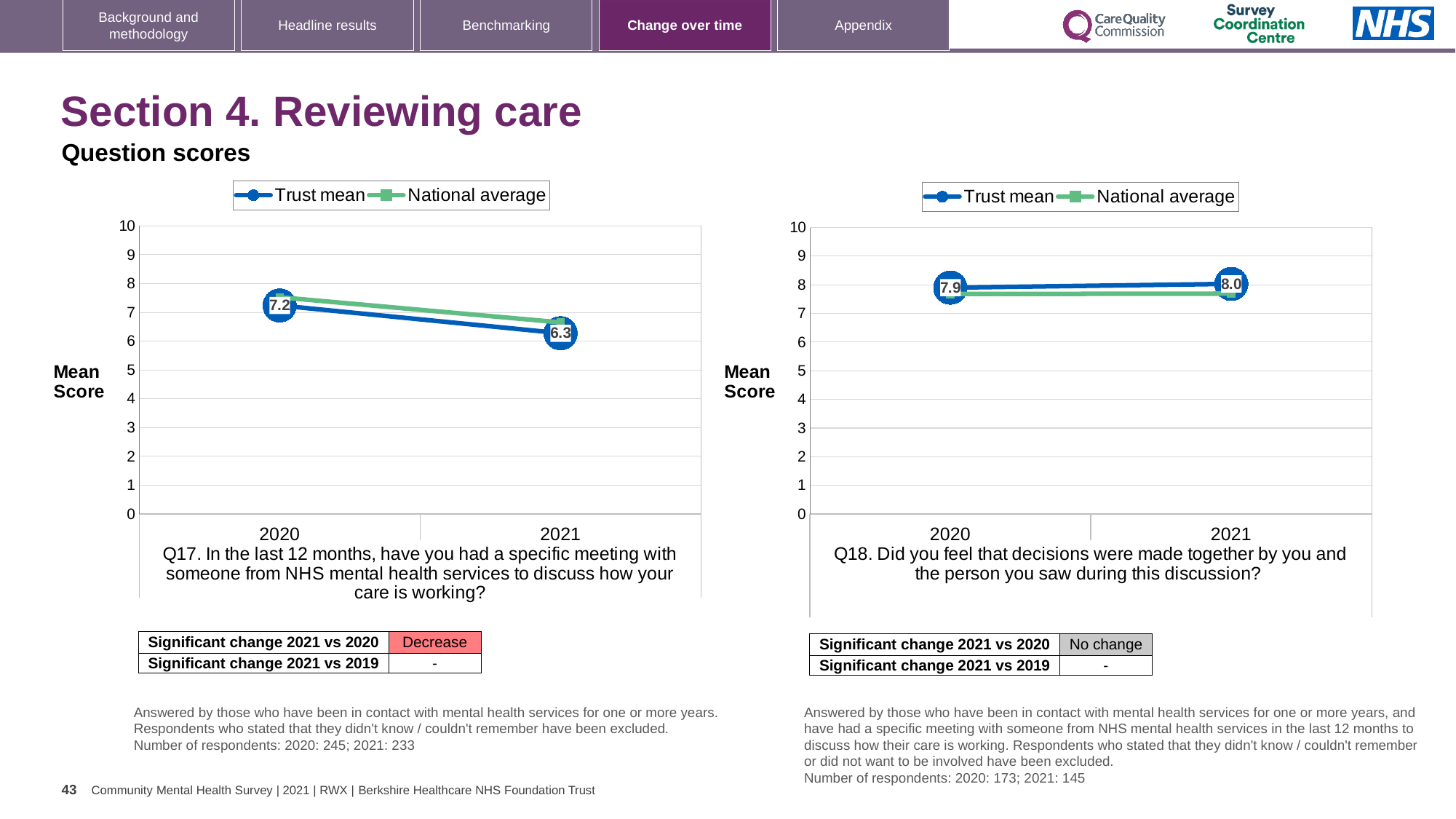
In the Q17 chart on the left, is the National average for 2020 greater or less than 7? greater How many series does the legend of the Q18 chart on the right list? 2 In the Q17 chart on the left, by how much did the Trust mean fall from 2020 to 2021? 0.9 What kind of chart is the Q18 chart on the right? line chart In the Q17 chart on the left, which year has the higher Trust mean? 2020 In the Q17 chart on the left, does the Trust mean rise or fall from 2020 to 2021? fall In the Q17 chart on the left, is the National average for 2021 greater or less than 7? less In the Q18 chart on the right, what is the Trust mean for 2021? 8.0 In the Q17 chart on the left, what is the Trust mean for 2021? 6.3 In the Q18 chart on the right, what is the Trust mean for 2020? 7.9 In the Q17 chart on the left, what is the Trust mean for 2020? 7.2 How many years are shown on the x axis of the Q17 chart on the left? 2